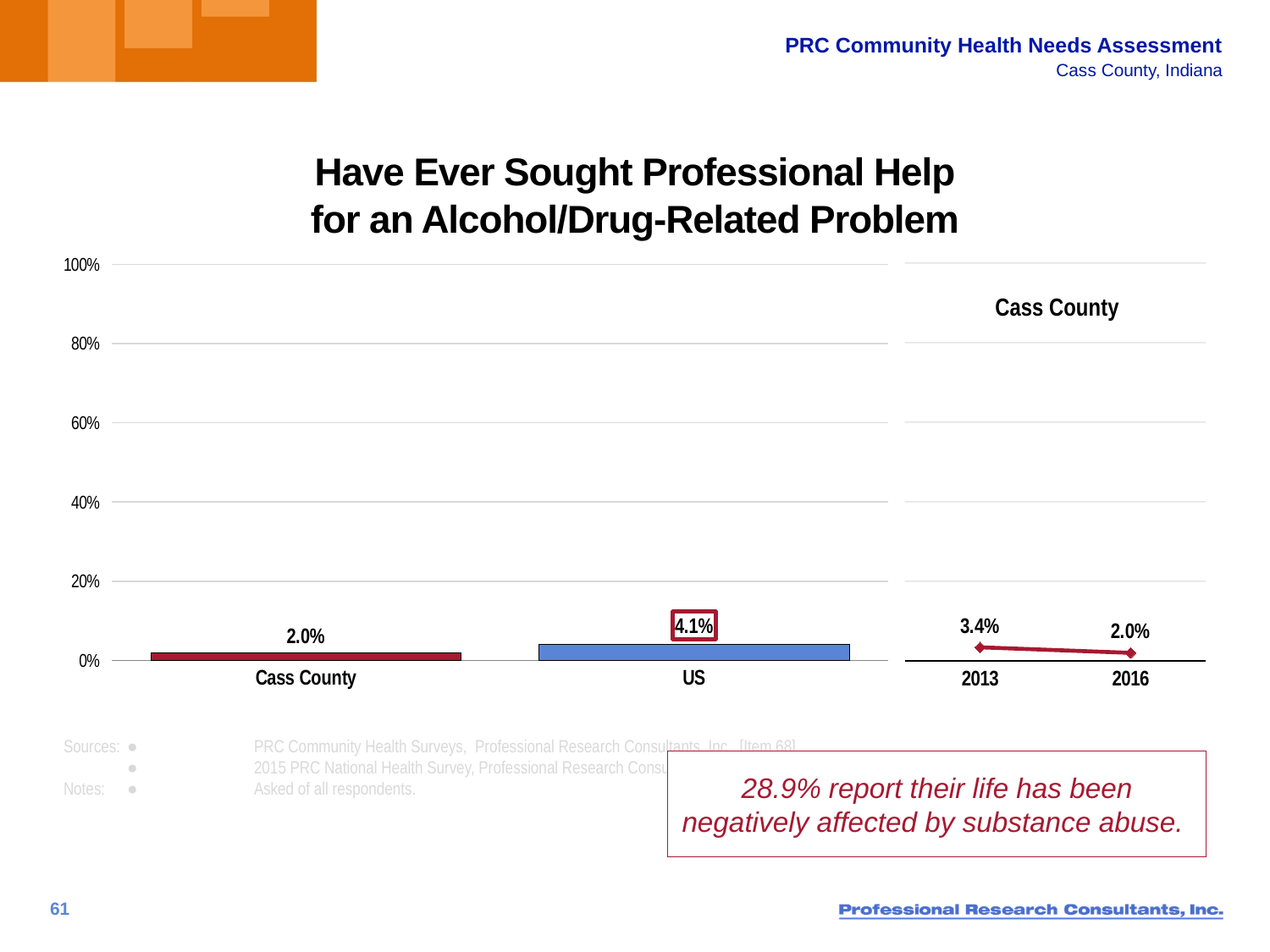
In the bar chart on the left, what is the value for US? 4.1% In the Cass County trend chart on the right, what is the value for 2013? 3.4% What kind of chart is the chart on the left? bar chart In the Cass County trend chart on the right, what is the difference between the 2013 and 2016 values? 1.4% In the Cass County trend chart on the right, do the values rise or fall from 2013 to 2016? fall In the bar chart on the left, what is the value for Cass County? 2.0% In the bar chart on the left, what is the difference between the US value and the Cass County value? 2.1% In the bar chart on the left, how many categories are shown? 2 In the bar chart on the left, which category has the higher value, Cass County or US? US In the Cass County trend chart on the right, what is the value for 2016? 2.0% In the bar chart on the left, is the value for US greater or less than 20%? less What is the title of the chart on the slide? Have Ever Sought Professional Help for an Alcohol/Drug-Related Problem